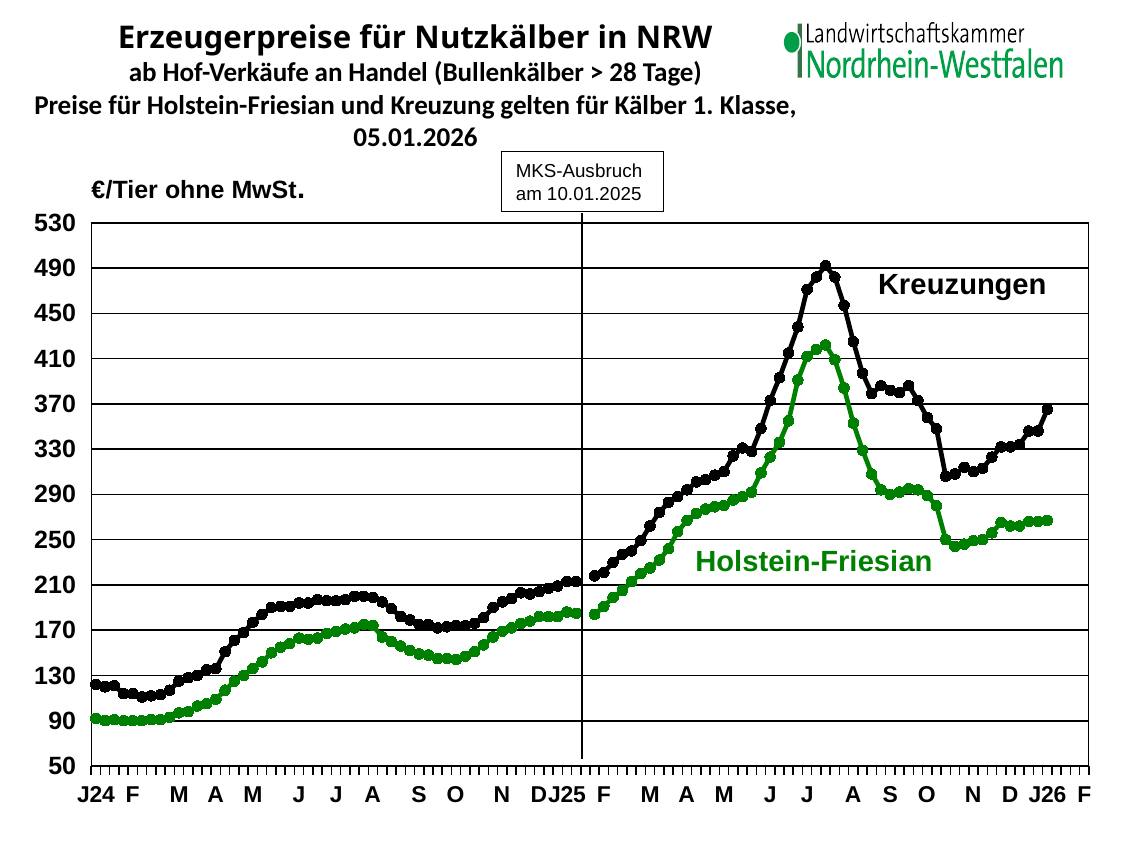
Is the peak value of the Kreuzungen series greater or less than 450? greater What type of chart is shown on the slide? line chart Do the Kreuzungen values rise or fall between J24 and M (May 2024)? rise Is the peak value of the Holstein-Friesian series greater or less than 450? less How many data series are plotted in the chart? 2 Is the Holstein-Friesian value at the start of the chart (J24) greater or less than 130? less Is the Holstein-Friesian value higher at J26 or at J24? J26 Which series has the higher values throughout the chart, Kreuzungen or Holstein-Friesian? Kreuzungen What event and date does the annotation box above the vertical line in the chart mark? MKS-Ausbruch am 10.01.2025 What unit is given for the y axis of the chart? €/Tier ohne MwSt.